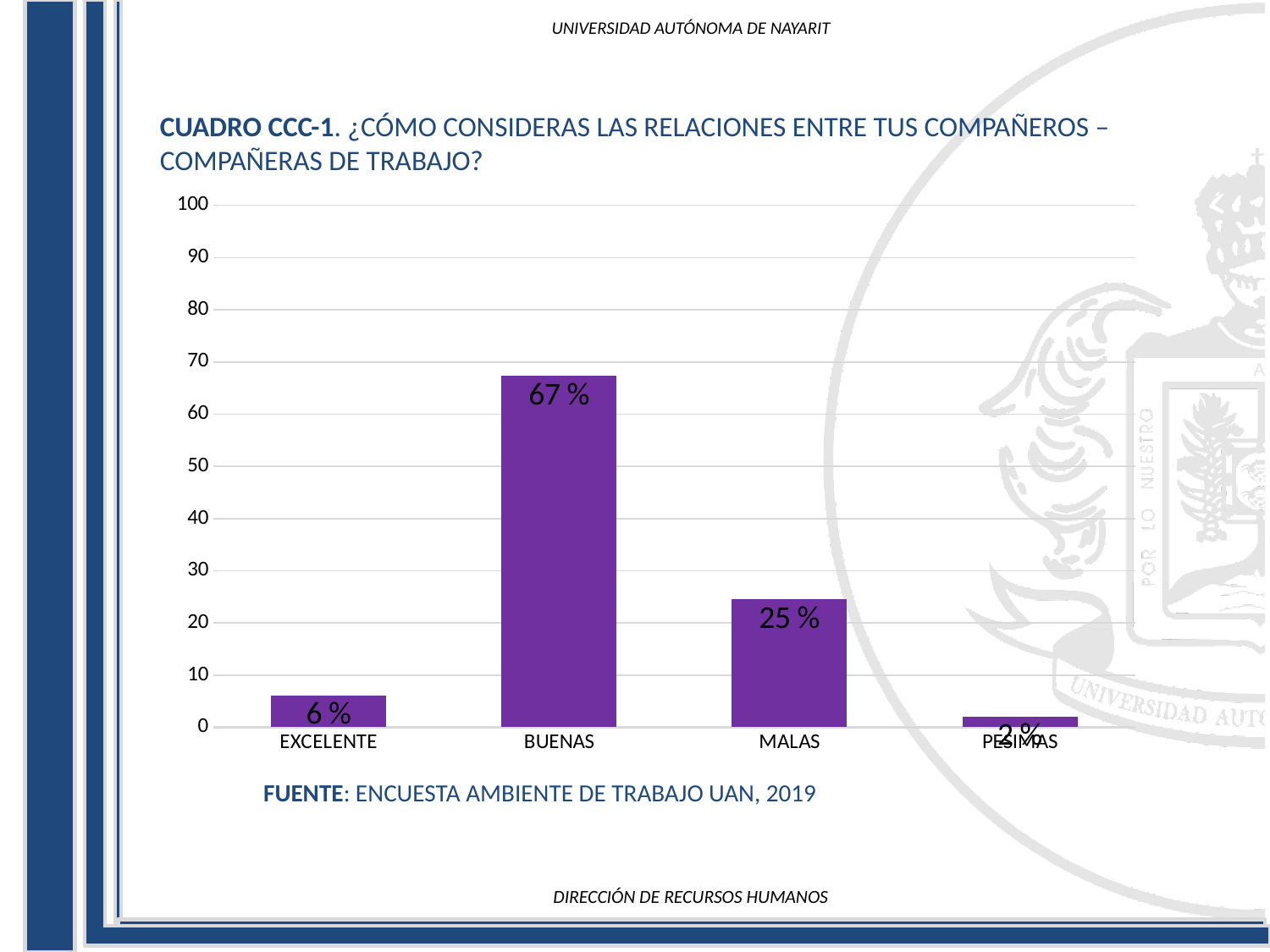
What is the difference between the values for MALAS and EXCELENTE? 19 % What kind of chart is shown on the slide? bar chart How many categories are shown on the x axis? 4 Is the value for BUENAS greater or less than 60? greater Which category has the highest value? BUENAS Which is larger, the value for EXCELENTE or the value for MALAS? MALAS What is the difference between the values for BUENAS and MALAS? 42 % What is the value for BUENAS? 67 % What is the value for EXCELENTE? 6 % Which category has the lowest value? PESIMAS What is the value for MALAS? 25 % What source is cited below the chart? ENCUESTA AMBIENTE DE TRABAJO UAN, 2019